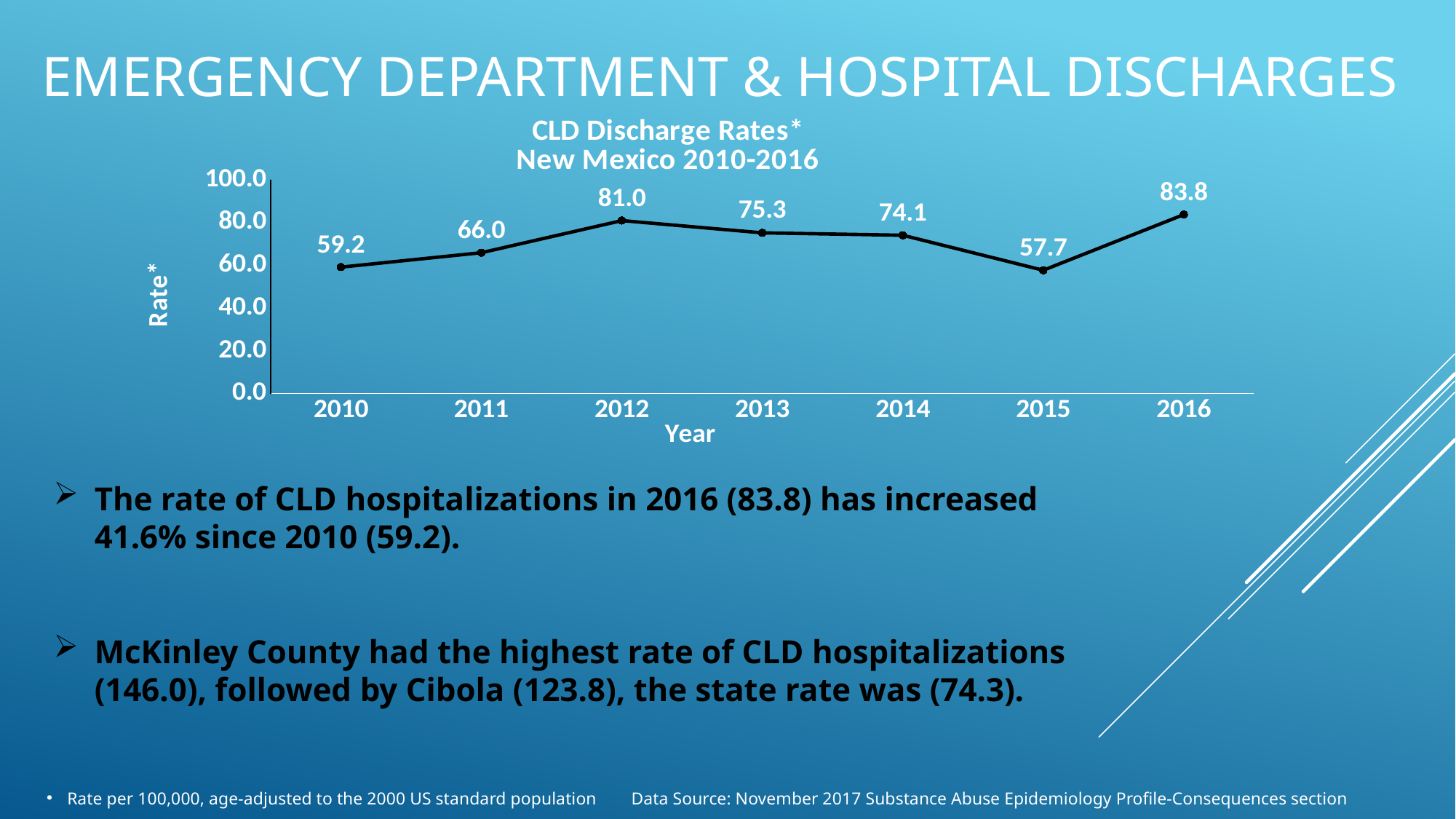
Which year has the highest CLD discharge rate? 2016 What is the CLD discharge rate for 2012? 81.0 What kind of chart is shown on the slide? line chart What is the difference between the CLD discharge rates for 2012 and 2011? 15.0 How many years are plotted on the chart? 7 Which year has a higher CLD discharge rate, 2013 or 2014? 2013 Which year has the lowest CLD discharge rate? 2015 What is the CLD discharge rate for 2015? 57.7 Is the CLD discharge rate for 2016 greater or less than 80.0? greater What is the title of the chart? CLD Discharge Rates* New Mexico 2010-2016 What is the CLD discharge rate for 2010? 59.2 What is the difference between the CLD discharge rates for 2016 and 2010? 24.6